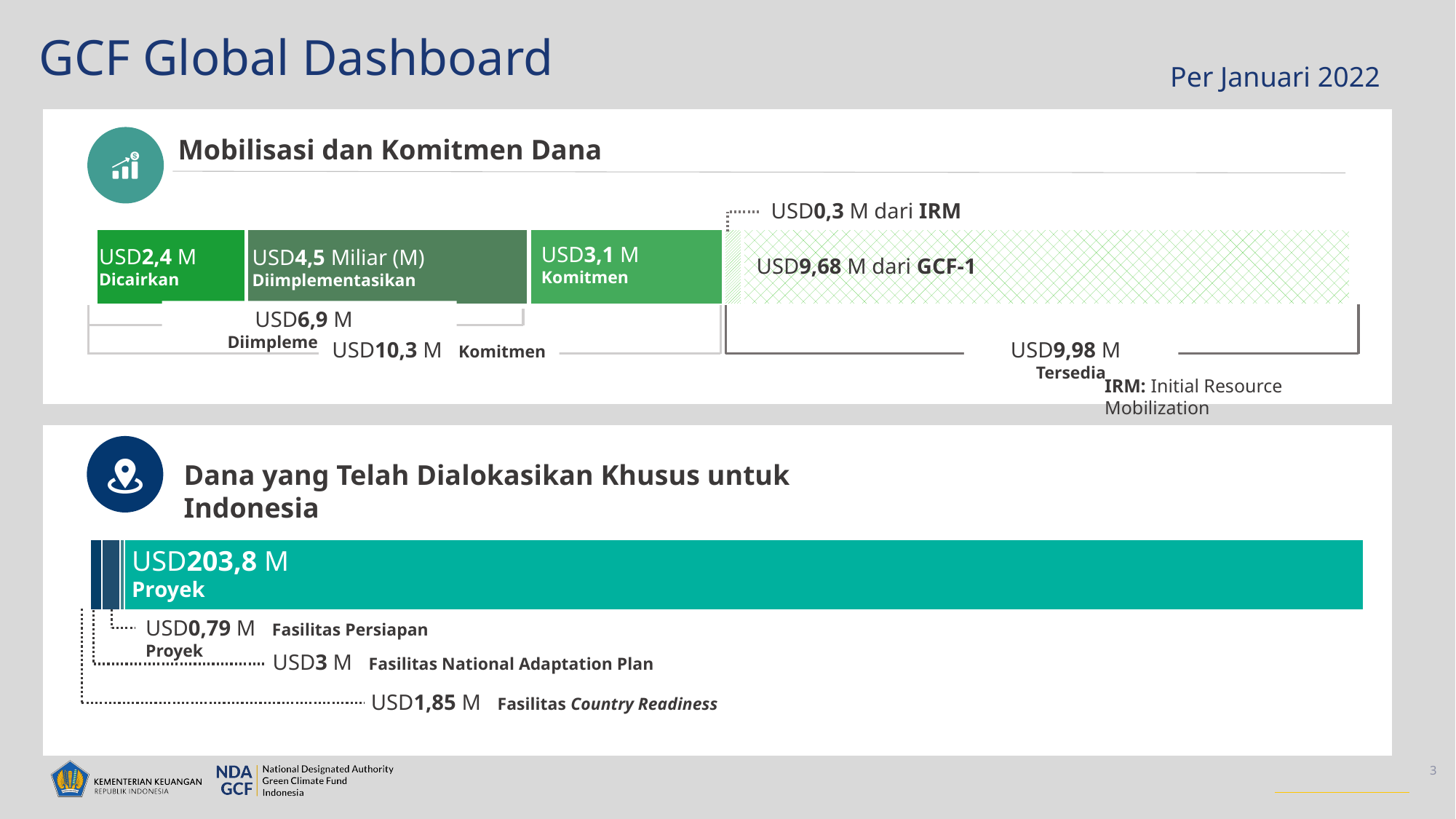
In the top chart 'Mobilisasi dan Komitmen Dana', what is the total labelled 'Tersedia'? USD9,98 M In the top chart 'Mobilisasi dan Komitmen Dana', how much comes from IRM? USD0,3 M What kind of chart is used in the bottom section 'Dana yang Telah Dialokasikan Khusus untuk Indonesia'? Stacked bar chart In the top chart 'Mobilisasi dan Komitmen Dana', what is the difference between the 'Diimplementasikan' segment (USD4,5 M) and the 'Dicairkan' segment (USD2,4 M)? USD2,1 M In the top chart 'Mobilisasi dan Komitmen Dana', what is the value labelled 'Komitmen' in the bar segment? USD3,1 M In the bottom chart 'Dana yang Telah Dialokasikan Khusus untuk Indonesia', which is larger: 'Fasilitas National Adaptation Plan' or 'Fasilitas Country Readiness'? Fasilitas National Adaptation Plan In the bottom chart 'Dana yang Telah Dialokasikan Khusus untuk Indonesia', which category has the smallest value? Fasilitas Persiapan Proyek In the top chart 'Mobilisasi dan Komitmen Dana', what is the value labelled 'Diimplementasikan' in the bar segment? USD4,5 Miliar (M) In the bottom chart 'Dana yang Telah Dialokasikan Khusus untuk Indonesia', what is the value for 'Fasilitas National Adaptation Plan'? USD3 M In the bottom chart 'Dana yang Telah Dialokasikan Khusus untuk Indonesia', what is the value for 'Proyek'? USD203,8 M In the top chart 'Mobilisasi dan Komitmen Dana', how much comes from GCF-1? USD9,68 M In the top chart 'Mobilisasi dan Komitmen Dana', what is the value labelled 'Dicairkan'? USD2,4 M